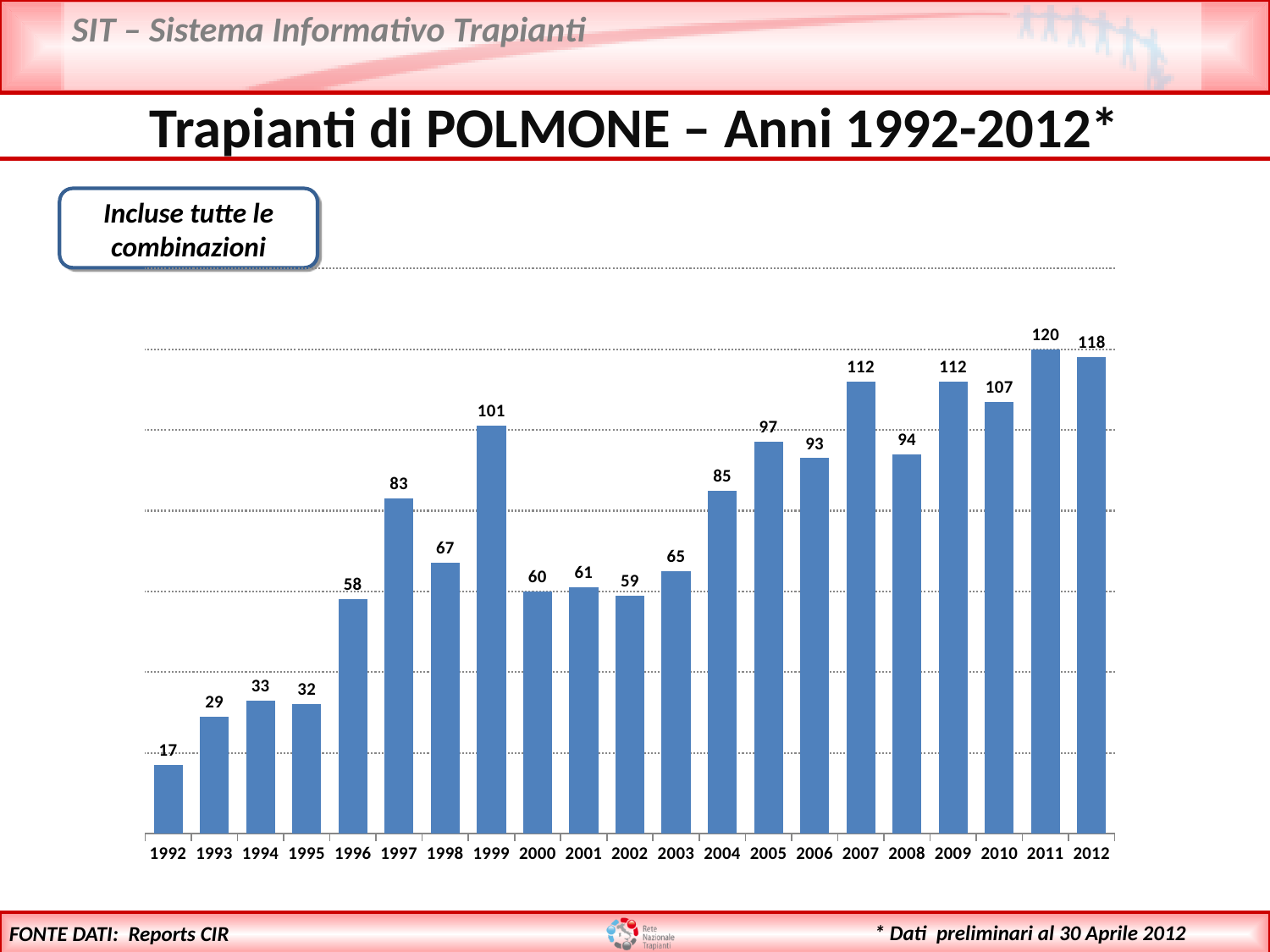
Which year has the highest value? 2011 How many years are shown on the x axis? 21 What is the value for 1992? 17 What kind of chart is shown on the slide? bar chart What is the difference between the values for 2011 and 2012? 2 Which is larger, the value for 2005 or the value for 2006? 2005 What is the title of the slide's chart? Trapianti di POLMONE – Anni 1992-2012* What is the value for 2010? 107 What is the difference between the values for 1997 and 1996? 25 Which year has the lowest value? 1992 What is the value for 1999? 101 Which is larger, the value for 1998 or the value for 2003? 1998